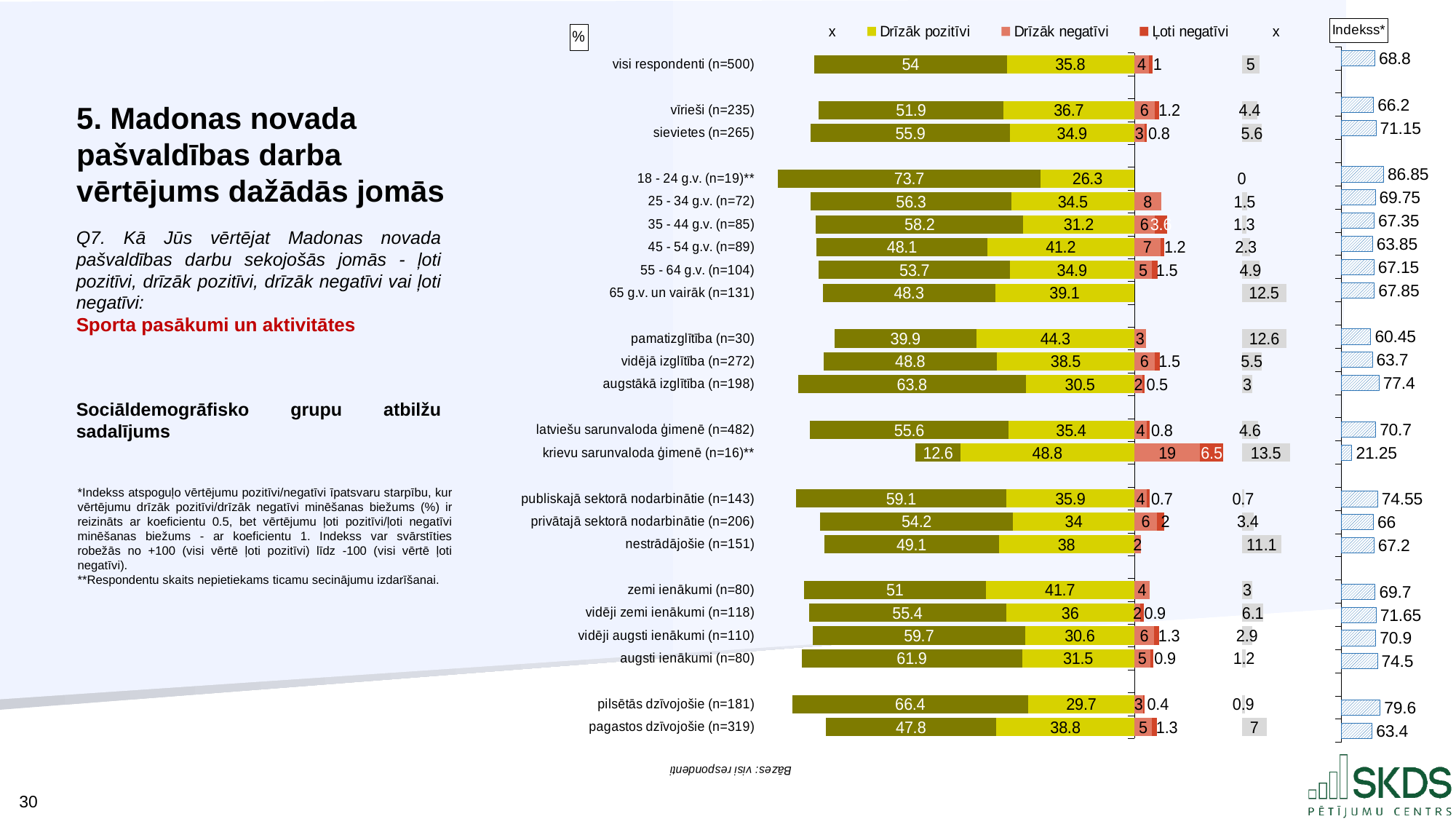
What is the 'Drīzāk pozitīvi' value for 'visi respondenti (n=500)'? 35.8 What is the Indekss* value for 'pilsētās dzīvojošie (n=181)'? 79.6 What is the difference between the 'Drīzāk pozitīvi' values for 'pamatizglītība (n=30)' and 'augstākā izglītība (n=198)'? 13.8 Which group has the highest Indekss* value? 18 - 24 g.v. (n=19)** How many sociodemographic groups (rows) are plotted in the chart? 23 What is the value of the leftmost (dark olive) segment for '18 - 24 g.v. (n=19)**'? 73.7 What is the difference between the Indekss* values for 'sievietes (n=265)' and 'vīrieši (n=235)'? 4.95 What is the 'Drīzāk negatīvi' value for 'krievu sarunvaloda ģimenē (n=16)**'? 19 What type of chart is used to show the evaluation breakdown by sociodemographic group? stacked bar chart Which has a larger leftmost (dark olive) segment value: 'augstākā izglītība (n=198)' or 'pamatizglītība (n=30)'? augstākā izglītība (n=198) Which group has the lowest Indekss* value? krievu sarunvaloda ģimenē (n=16)** Which legend entry is shown in yellow? Drīzāk pozitīvi